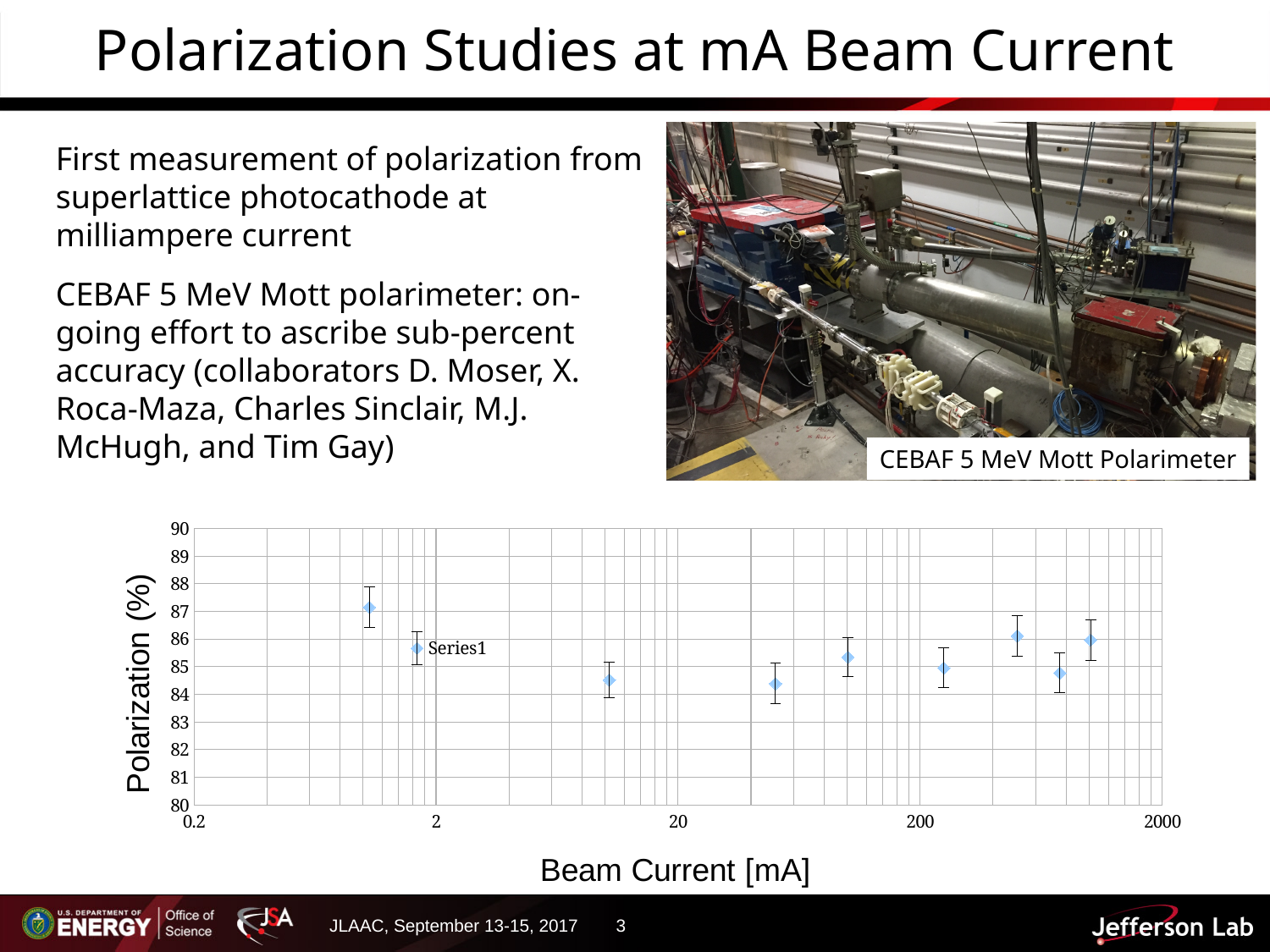
Are all plotted polarization values greater or less than 88? less What kind of chart is shown on the slide? scatter plot Is the polarization value of the data point near 10 mA greater or less than 85? less What is the title of the x axis of the chart? Beam Current [mA] How many data points are plotted in the chart? 9 How many series does the chart show? 1 Which data point has the highest polarization value? the leftmost point (lowest beam current) What is the title of the y axis of the chart? Polarization (%) Which has the larger polarization value: the leftmost data point or the rightmost data point? the leftmost data point Is the polarization value of the leftmost data point greater or less than 86? greater Do the polarization values rise or fall across the first three data points from left to right? fall